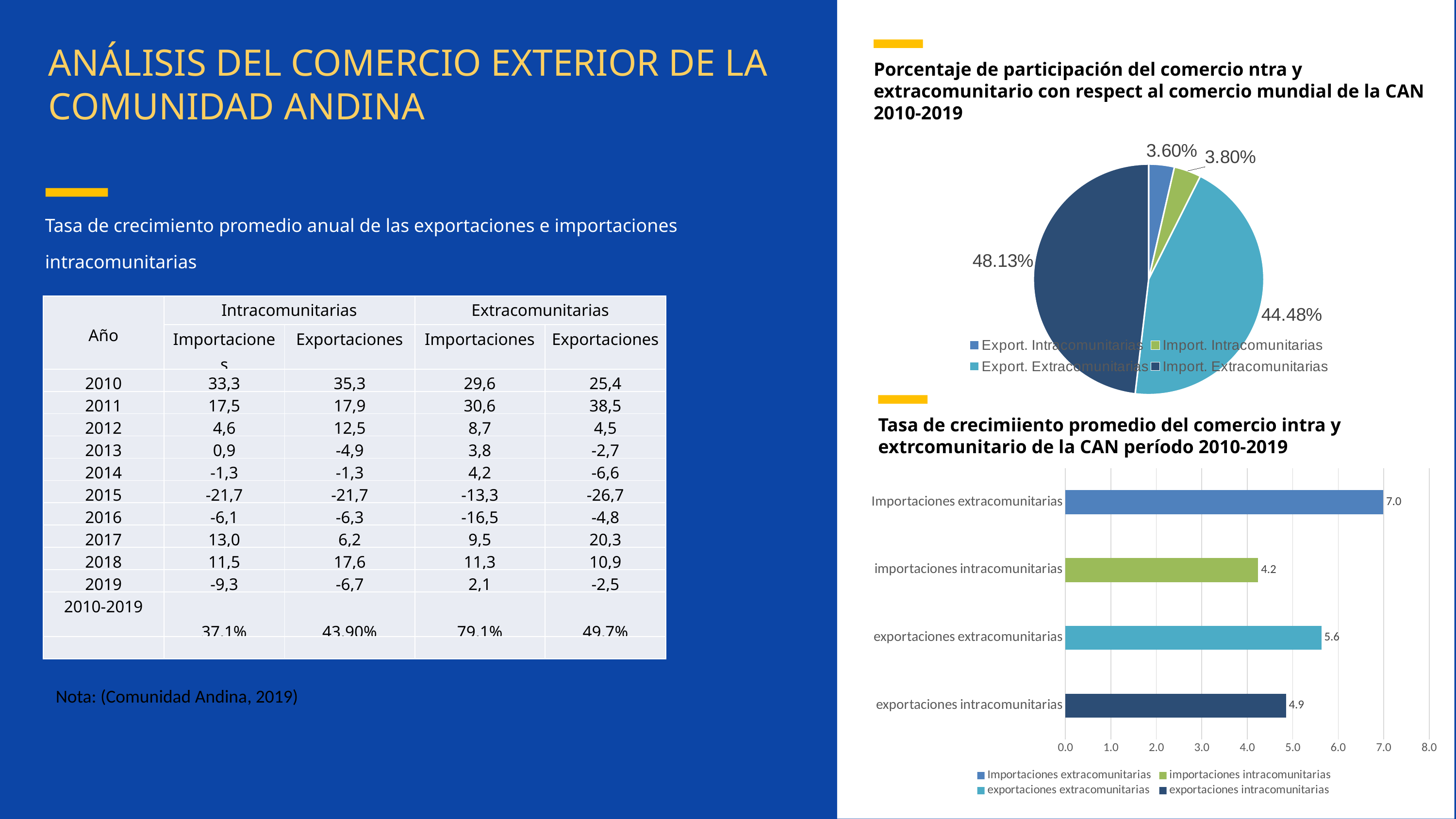
In the bar chart 'Tasa de crecimiiento promedio del comercio intra y extrcomunitario', what is the value for Importaciones extracomunitarias? 7.0 In the pie chart 'Porcentaje de participación del comercio ntra y extracomunitario', how many slices are there? 4 In the pie chart 'Porcentaje de participación del comercio ntra y extracomunitario', which slice is the smallest? Export. Intracomunitarias In the bar chart 'Tasa de crecimiiento promedio del comercio intra y extrcomunitario', what is the difference between Importaciones extracomunitarias and exportaciones extracomunitarias? 1.4 In the pie chart 'Porcentaje de participación del comercio ntra y extracomunitario', what is the share for Import. Extracomunitarias? 48.13% In the pie chart 'Porcentaje de participación del comercio ntra y extracomunitario', what is the share for Export. Extracomunitarias? 44.48% In the bar chart 'Tasa de crecimiiento promedio del comercio intra y extrcomunitario', what is the value for exportaciones intracomunitarias? 4.9 In the pie chart 'Porcentaje de participación del comercio ntra y extracomunitario', which slice is the largest? Import. Extracomunitarias In the bar chart 'Tasa de crecimiiento promedio del comercio intra y extrcomunitario', which category has the lowest value? importaciones intracomunitarias What kind of chart is the bottom-right chart 'Tasa de crecimiiento promedio del comercio intra y extrcomunitario de la CAN período 2010-2019'? Bar chart In the pie chart 'Porcentaje de participación del comercio ntra y extracomunitario', what is the difference between the Import. Extracomunitarias and Export. Extracomunitarias shares? 3.65% In the bar chart 'Tasa de crecimiiento promedio del comercio intra y extrcomunitario', how many entries does the legend list? 4